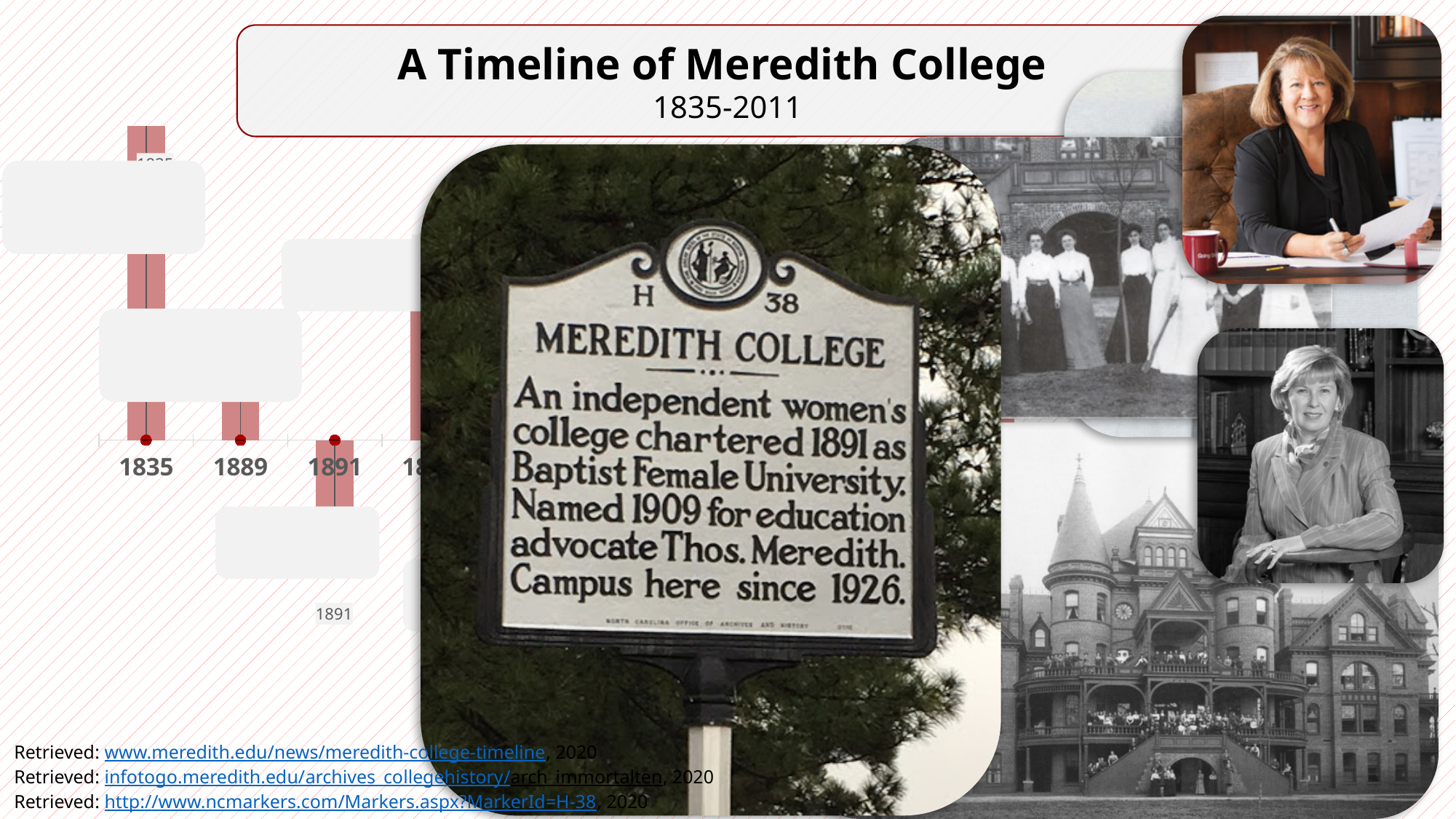
Which year label appears immediately after 1889 on the timeline axis? 1891 Which year label appears immediately after 1835 on the timeline axis? 1889 What is the title shown above the timeline chart? A Timeline of Meredith College What is the first year label on the timeline's horizontal axis? 1835 Do the year labels along the timeline's horizontal axis increase or decrease from left to right? increase What range of years does the chart's subtitle give? 1835-2011 On the timeline axis, which appears further to the left, 1889 or 1891? 1889 What kind of chart is shown on the left of the slide? timeline chart